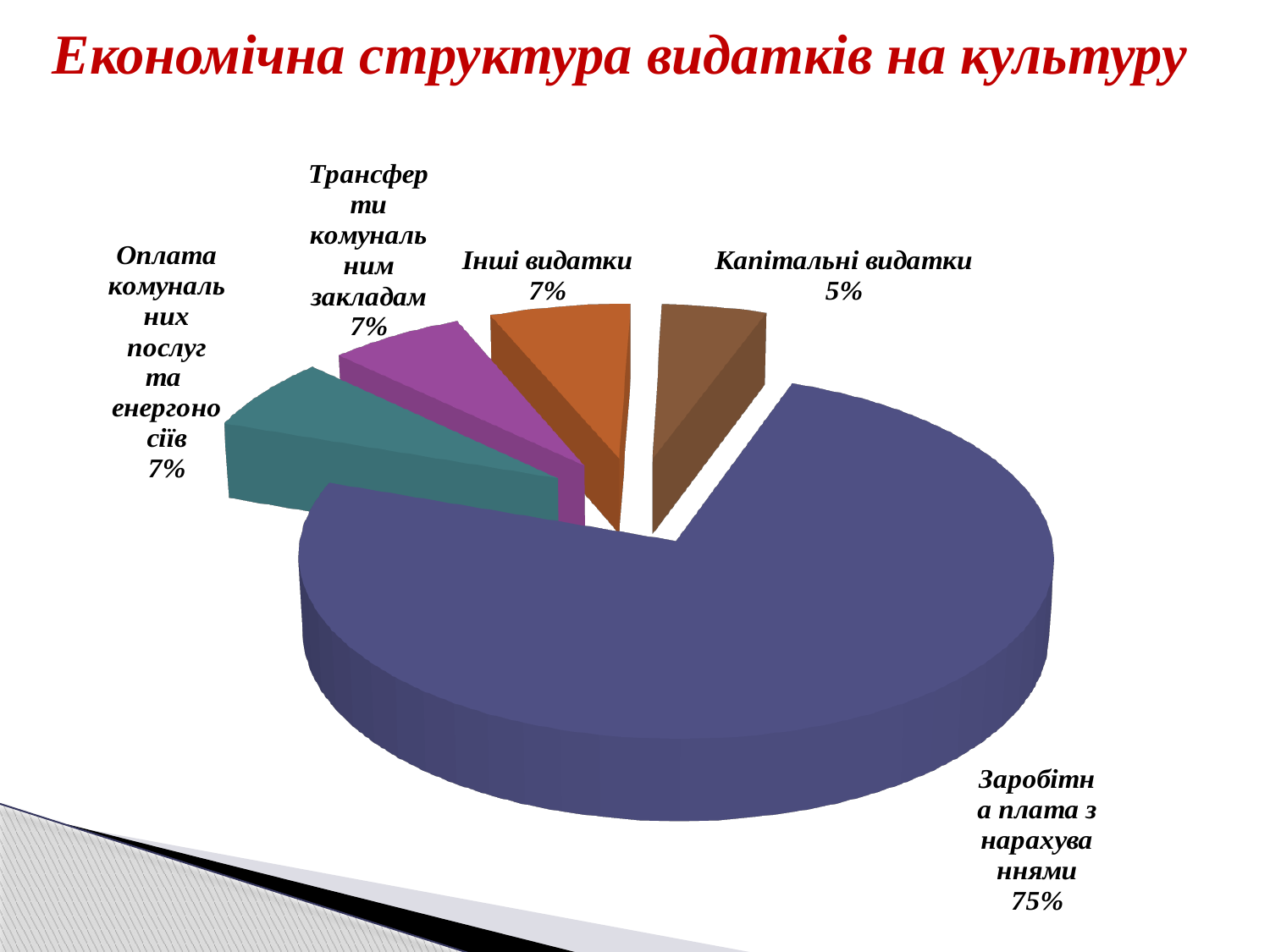
Which category has the largest share of the pie? Заробітна плата з нарахуваннями Which category has the smallest share of the pie? Капітальні видатки What kind of chart is shown on the slide? Pie chart What is the title of the slide? Економічна структура видатків на культуру What share of the pie does Заробітна плата з нарахуваннями take? 75% How many slices does the pie chart have? 5 Which is larger: the share of Інші видатки or the share of Капітальні видатки? Інші видатки What is the value shown for Трансферти комунальним закладам? 7% What is the difference between the shares of Заробітна плата з нарахуваннями and Капітальні видатки? 70% What is the value shown for Інші видатки? 7% What is the value shown for Оплата комунальних послуг та енергоносіїв? 7% What is the value shown for Капітальні видатки? 5%